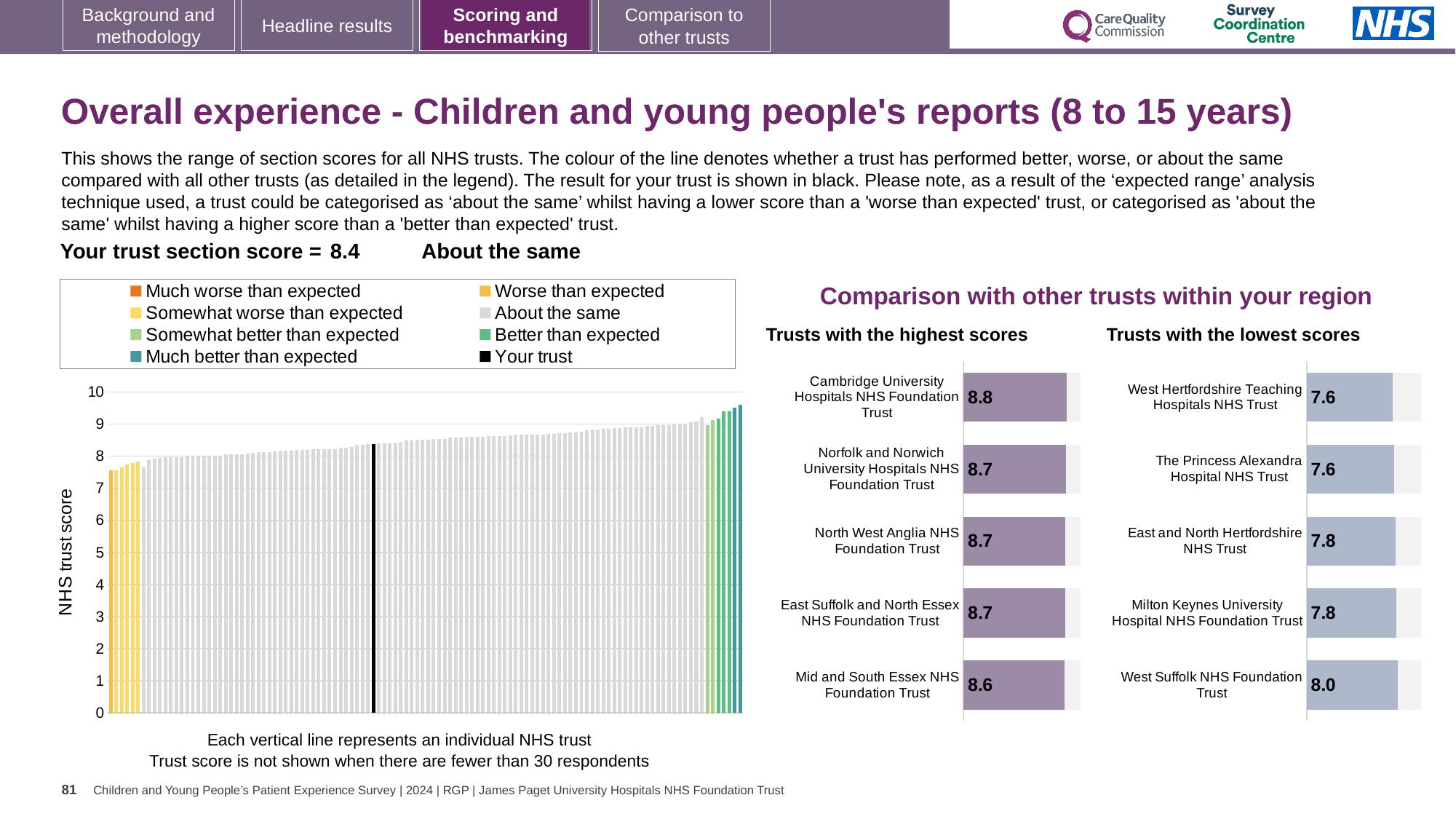
In the 'Trusts with the highest scores' chart, what is the score for Cambridge University Hospitals NHS Foundation Trust? 8.8 In the 'Trusts with the highest scores' chart, what is the score for Mid and South Essex NHS Foundation Trust? 8.6 In the 'Trusts with the lowest scores' chart, what is the score for East and North Hertfordshire NHS Trust? 7.8 In the 'Trusts with the lowest scores' chart, which trust has the highest score? West Suffolk NHS Foundation Trust In the 'Trusts with the highest scores' chart, which trust has the highest score? Cambridge University Hospitals NHS Foundation Trust In the 'Trusts with the lowest scores' chart, what is the difference between the scores of West Suffolk NHS Foundation Trust and West Hertfordshire Teaching Hospitals NHS Trust? 0.4 In the 'Trusts with the highest scores' chart, what is the difference between the scores of Cambridge University Hospitals NHS Foundation Trust and Mid and South Essex NHS Foundation Trust? 0.2 How many trusts are listed in the 'Trusts with the highest scores' chart? 5 In the main 'NHS trust score' chart on the left, do the trust scores rise or fall from left to right? rise How many entries does the legend of the main 'NHS trust score' chart on the left list? 8 In the 'Trusts with the lowest scores' chart, which has the larger score: West Suffolk NHS Foundation Trust or Milton Keynes University Hospital NHS Foundation Trust? West Suffolk NHS Foundation Trust In the 'Trusts with the lowest scores' chart, what is the score for West Suffolk NHS Foundation Trust? 8.0